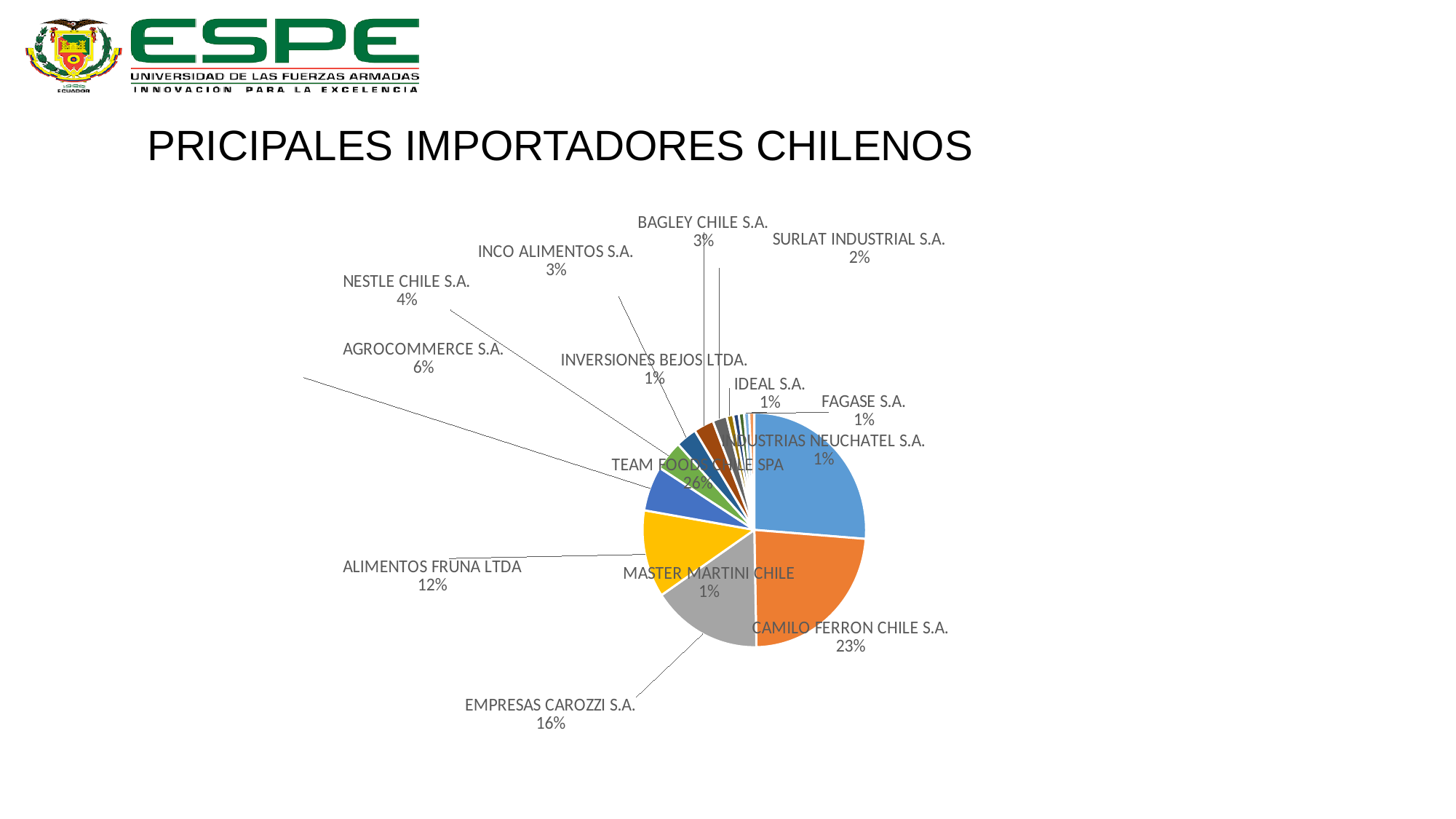
What is the title of the chart on the slide? PRICIPALES IMPORTADORES CHILENOS How many importers (slices) are labelled in the pie chart? 14 What percentage is shown for AGROCOMMERCE S.A.? 6% Which has a larger share, ALIMENTOS FRUNA LTDA or AGROCOMMERCE S.A.? ALIMENTOS FRUNA LTDA What percentage is shown for SURLAT INDUSTRIAL S.A.? 2% Which importer has the largest share of the pie? TEAM FOODS CHILE SPA What percentage is shown for NESTLE CHILE S.A.? 4% What percentage is shown for EMPRESAS CAROZZI S.A.? 16% What percentage is shown for ALIMENTOS FRUNA LTDA? 12% What kind of chart is shown on the slide? Pie chart What is the difference in percentage points between CAMILO FERRON CHILE S.A. and EMPRESAS CAROZZI S.A.? 7 What share of the pie does CAMILO FERRON CHILE S.A. hold? 23%